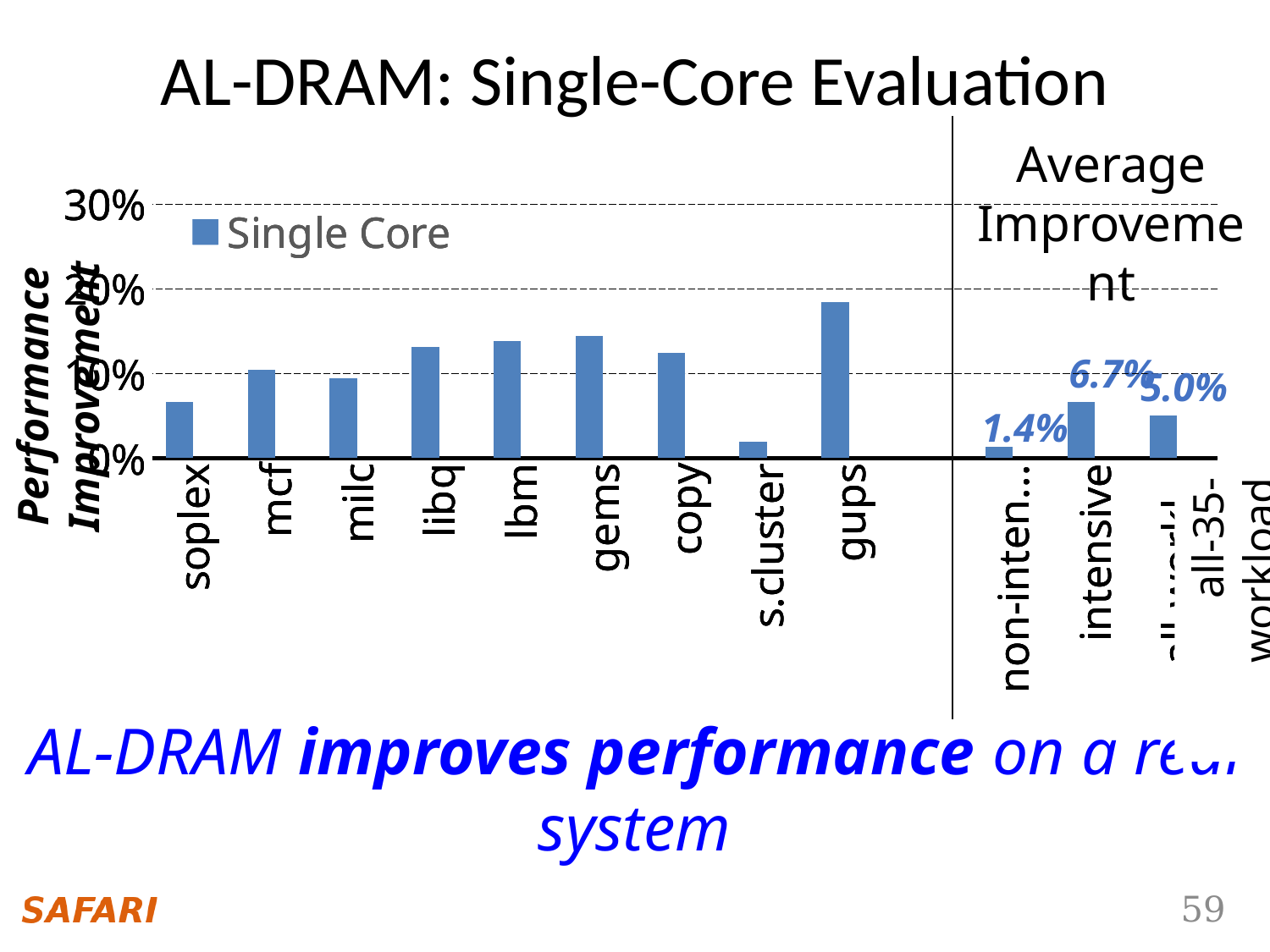
What type of chart is shown on the slide? Bar chart Is the performance improvement for gups greater or less than 10%? greater What is the difference between the average improvement for intensive workloads and for all 35 workloads? 1.7% Among the nine individual benchmarks (soplex through gups), which has the lowest performance improvement? s.cluster What is the average performance improvement shown for all 35 workloads? 5.0% Is the performance improvement for soplex greater or less than 10%? less Which benchmark has the highest single-core performance improvement? gups What is the average performance improvement shown for the non-intensive workloads? 1.4% What is the average performance improvement shown for the intensive workloads? 6.7% What is the difference between the average improvement for intensive and non-intensive workloads? 5.3% Which has a larger performance improvement, gups or copy? gups How many series does the legend list? 1